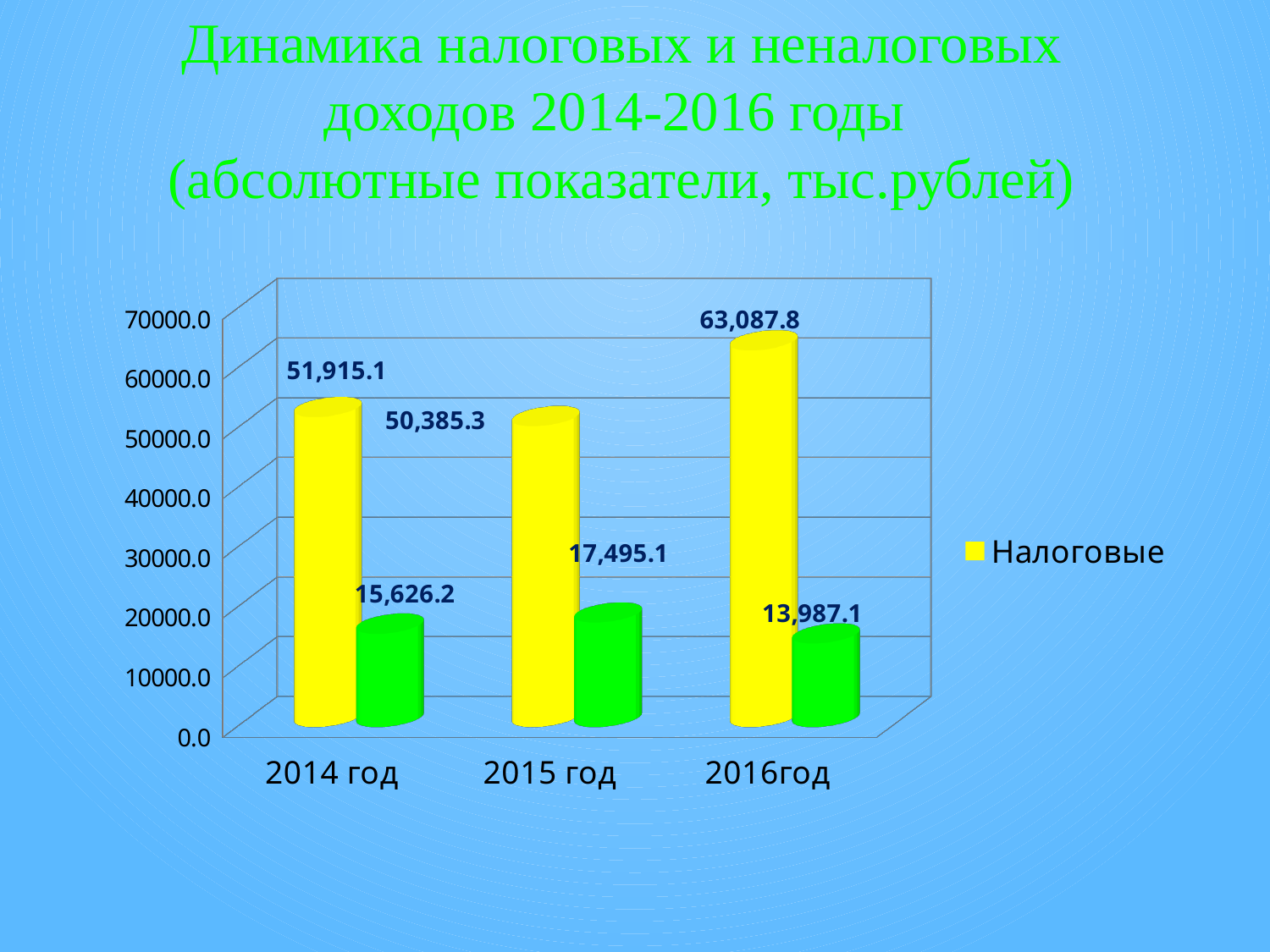
What is the value of the Налоговые (yellow) bar for 2014 год? 51,915.1 What is the difference between the Налоговые values for 2016год and 2015 год? 12,702.5 What type of chart is shown on the slide? Bar chart In which year is the green bar lowest? 2016год How many series does the legend list? 1 Which is larger: the green bar for 2014 год or the green bar for 2015 год? 2015 год In which year is the Налоговые (yellow) bar highest? 2016год Is the Налоговые value for 2015 год greater or less than 60000.0? less What is the value of the green bar for 2016год? 13,987.1 What is the value of the Налоговые (yellow) bar for 2016год? 63,087.8 How many years are shown on the x axis? 3 What is the value of the green bar for 2015 год? 17,495.1